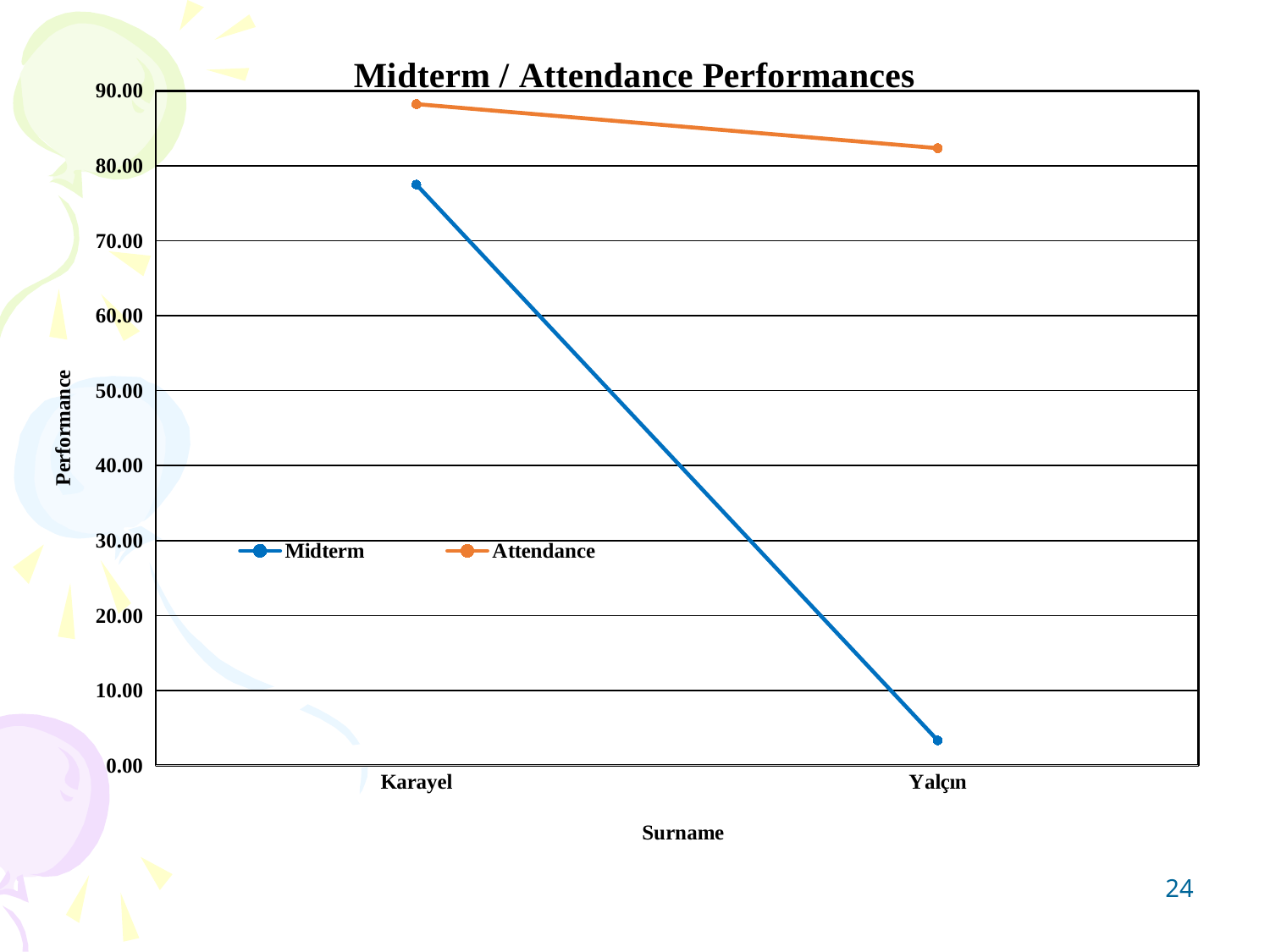
What is the label of the y axis? Performance Is the Midterm value for Yalçın greater or less than 10.00? less Does the Midterm series rise or fall from Karayel to Yalçın? fall Does the Attendance series rise or fall from Karayel to Yalçın? fall How many categories are shown on the x axis? 2 Which surname has the higher Midterm value, Karayel or Yalçın? Karayel Is the Attendance value for Yalçın greater or less than 80.00? greater Is the Midterm value for Karayel greater or less than 70.00? greater What is the title of the chart? Midterm / Attendance Performances What kind of chart is shown on the slide? line chart How many series does the legend list? 2 Which series has the higher value for Yalçın, Midterm or Attendance? Attendance